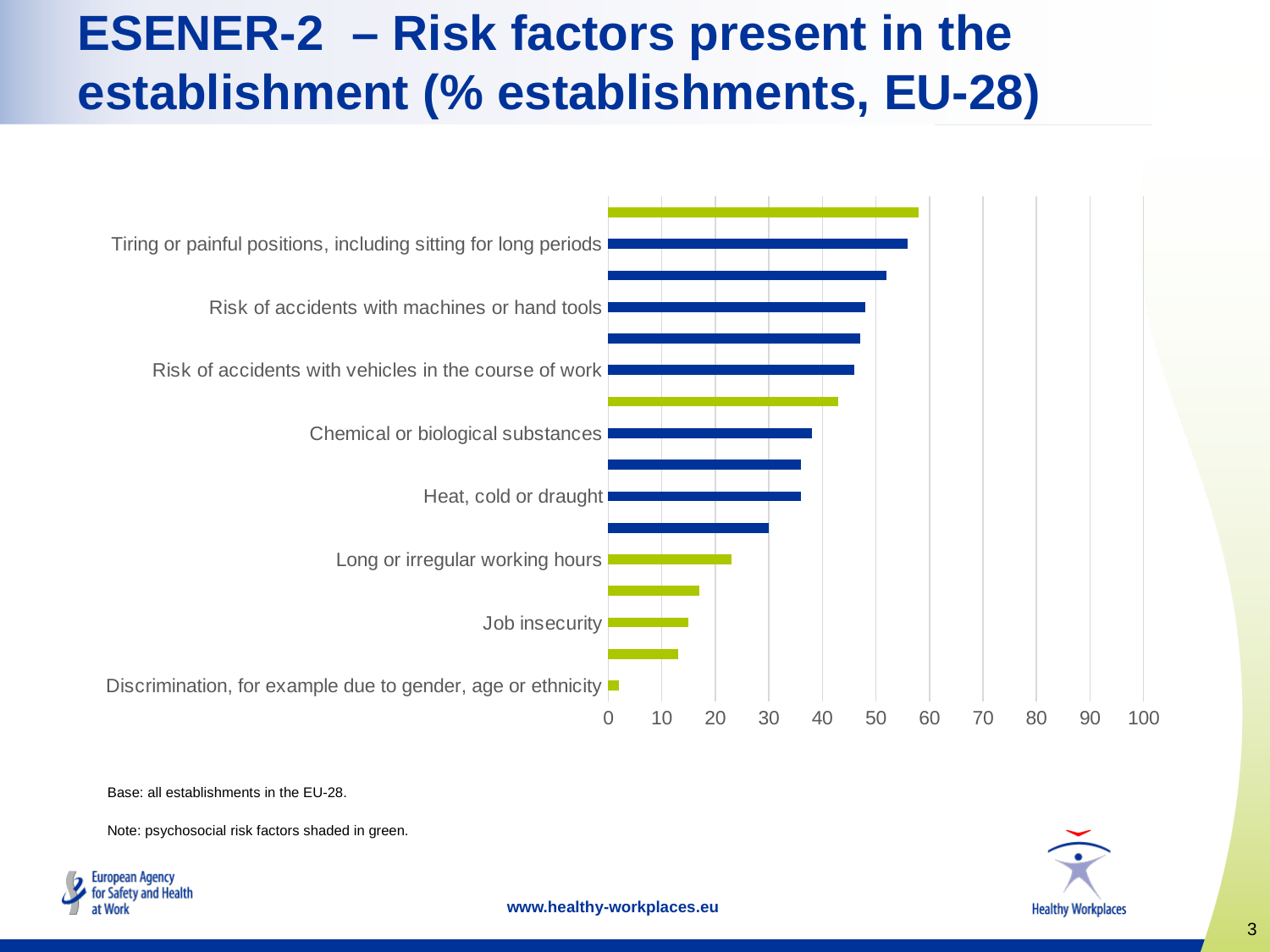
According to the note on the slide, what type of risk factors are shaded in green? psychosocial risk factors Is the value for 'Heat, cold or draught' greater or less than 40? less Is the value for 'Tiring or painful positions, including sitting for long periods' greater or less than 50? greater Is the value for 'Risk of accidents with machines or hand tools' greater or less than 40? greater Which is larger: the value for 'Tiring or painful positions, including sitting for long periods' or the value for 'Job insecurity'? Tiring or painful positions, including sitting for long periods What kind of chart is shown on the slide? bar chart Which category has the lowest value in the chart? Discrimination, for example due to gender, age or ethnicity